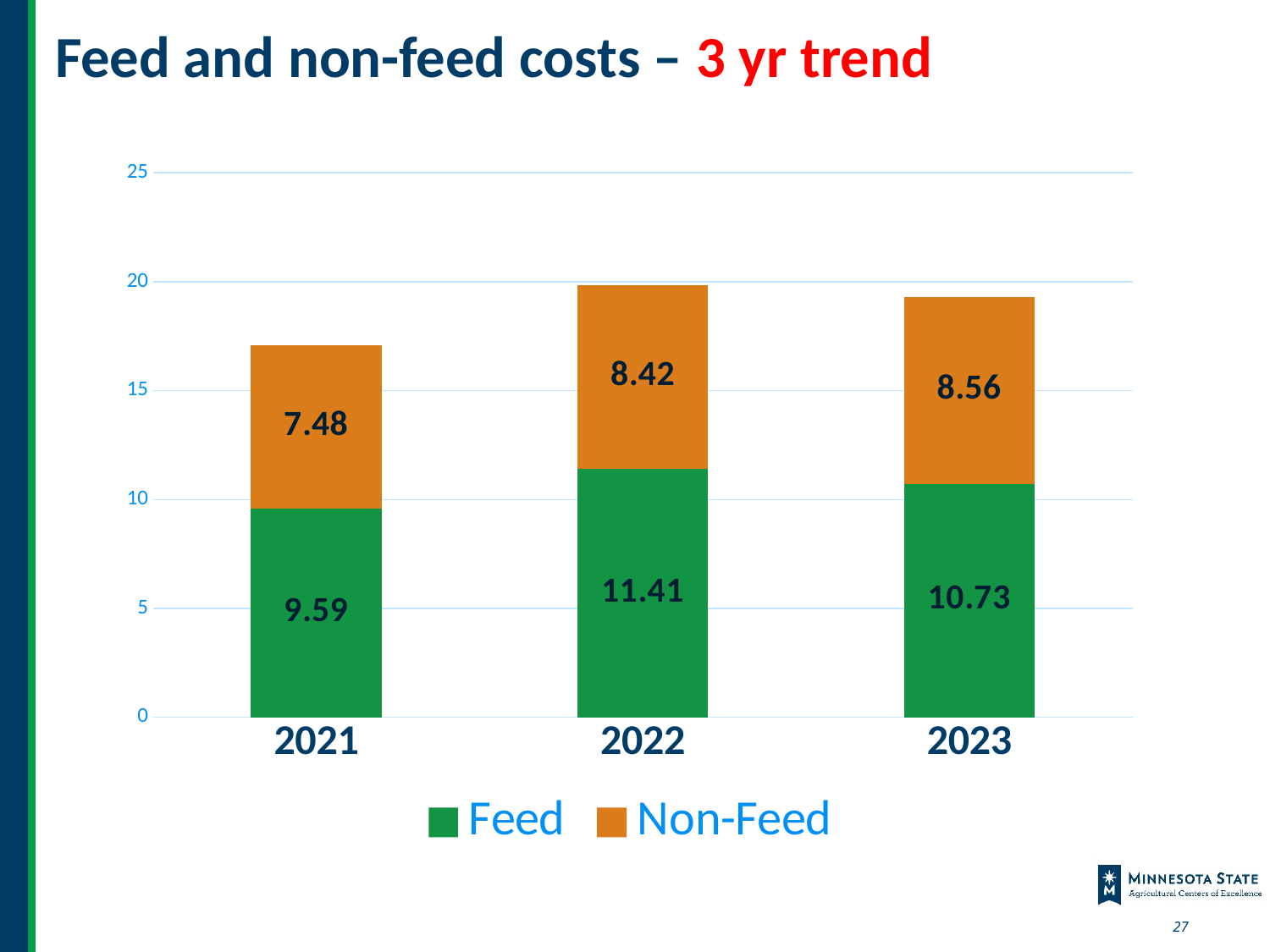
What is the total of the stacked bar for 2022? 19.83 Which year has the lowest Non-Feed value? 2021 What kind of chart is shown on the slide? Stacked bar chart What is the Non-Feed value for 2023? 8.56 What is the Non-Feed value for 2021? 7.48 Which year has the highest Feed value? 2022 How many series does the legend list? 2 How many years are shown on the x axis? 3 What is the difference between the Feed values for 2022 and 2021? 1.82 Which is larger, the Non-Feed value for 2022 or for 2023? 2023 What is the Feed value for 2022? 11.41 What is the total of the stacked bar for 2021? 17.07